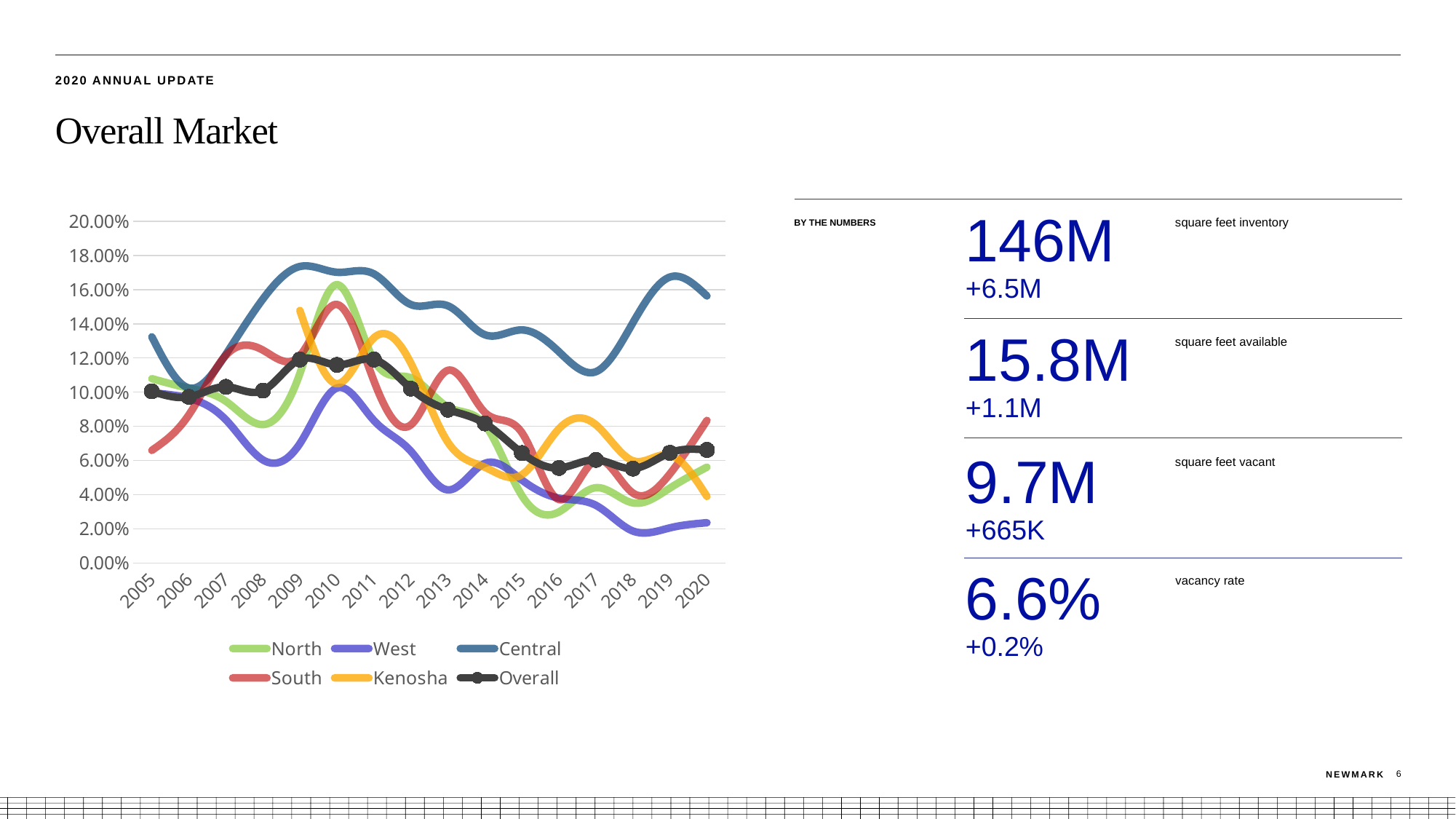
Is the value for Overall in 2005 greater or less than 8.00%? greater Which series has the highest value in 2020? Central In 2010, which is larger, the value for North or the value for West? North Which series in the legend is drawn with circular markers on its line? Overall Is the value for Central in 2009 greater or less than 16.00%? greater Is the value for West in 2018 greater or less than 4.00%? less What kind of chart is shown on the slide? line chart Which series has the lowest value in 2020? West Does the Overall series rise or fall between 2011 and 2016? fall How many years are shown along the x axis of the chart? 16 How many series does the chart legend list? 6